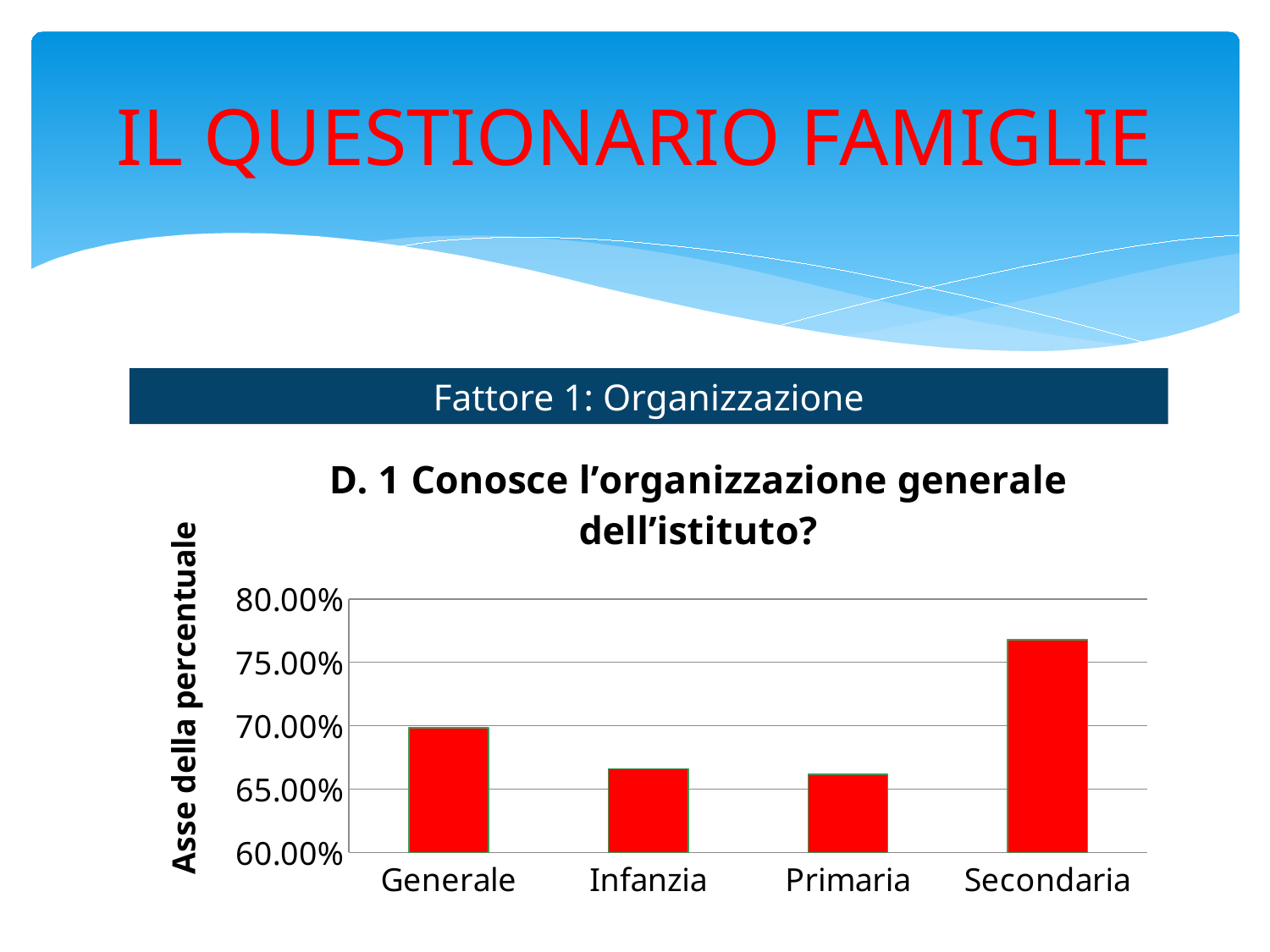
Which category has the highest value in the chart? Secondaria What is the title of the chart? D. 1 Conosce l'organizzazione generale dell'istituto? Is the value for Infanzia greater or less than 70.00%? less Is the value for Secondaria greater or less than 75.00%? greater Which is larger, the value for Generale or the value for Infanzia? Generale What is the label of the vertical axis of the chart? Asse della percentuale Is the value for Primaria greater or less than 65.00%? greater What kind of chart is shown on the slide? bar chart How many categories are shown on the x axis of the chart? 4 Which is larger, the value for Primaria or the value for Secondaria? Secondaria